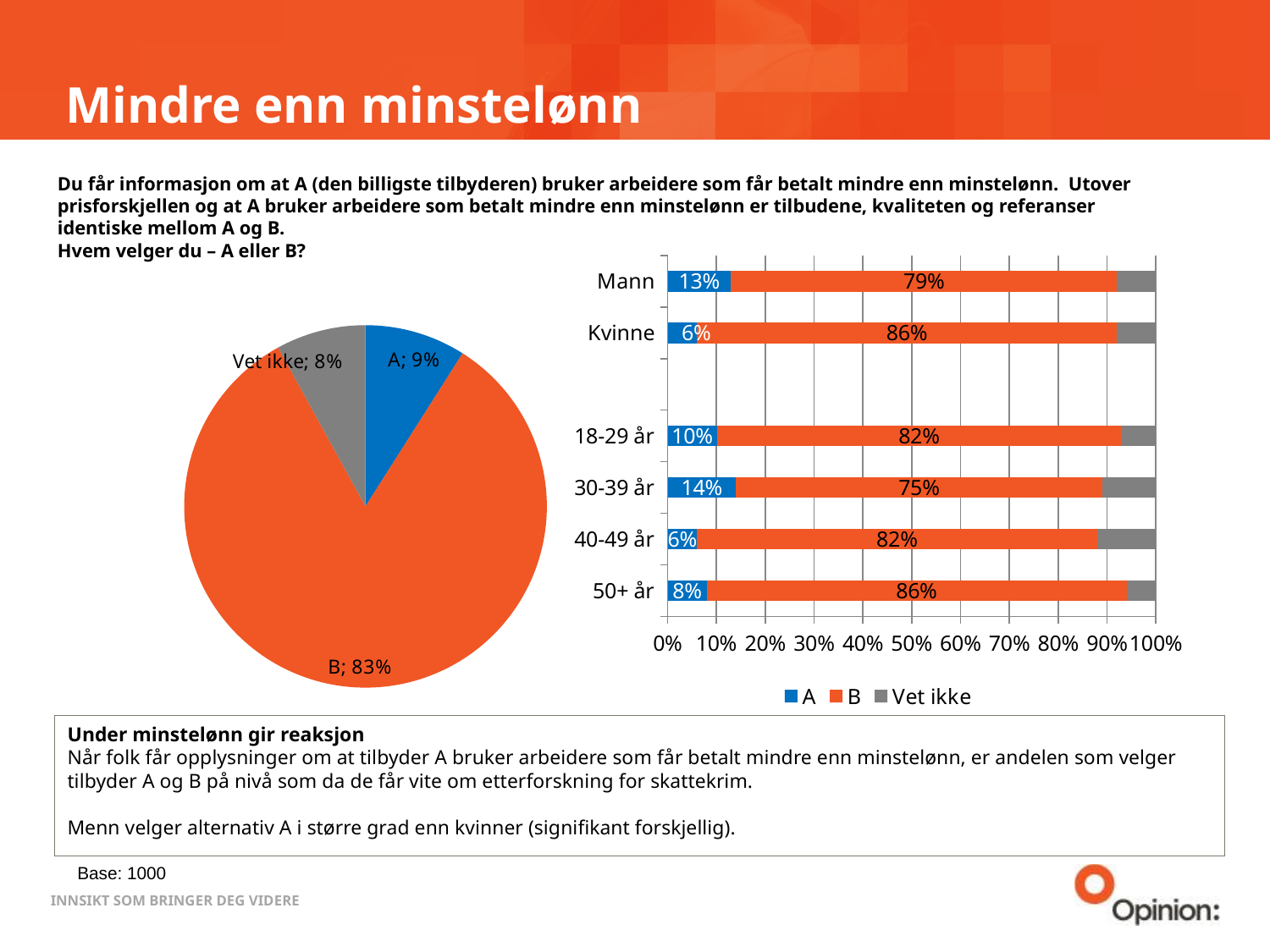
In the bar chart on the right, what is the value of B for 30-39 år? 75% In the bar chart on the right, what is the difference between the A values for Mann and Kvinne? 7% In the bar chart on the right, which is larger: the B value for 18-29 år or for 30-39 år? 18-29 år In the pie chart on the left, what share is labelled for B? 83% In the pie chart on the left, what share is labelled for A? 9% In the bar chart on the right, what is the value of B for Kvinne? 86% In the bar chart on the right, what is the value of A for Mann? 13% In the bar chart on the right, which category has the highest value for A? 30-39 år What type of chart is shown on the right side of the slide? Bar chart In the pie chart on the left, which slice is the largest? B In the pie chart on the left, how many slices are there? 3 In the bar chart on the right, how many series does the legend list? 3